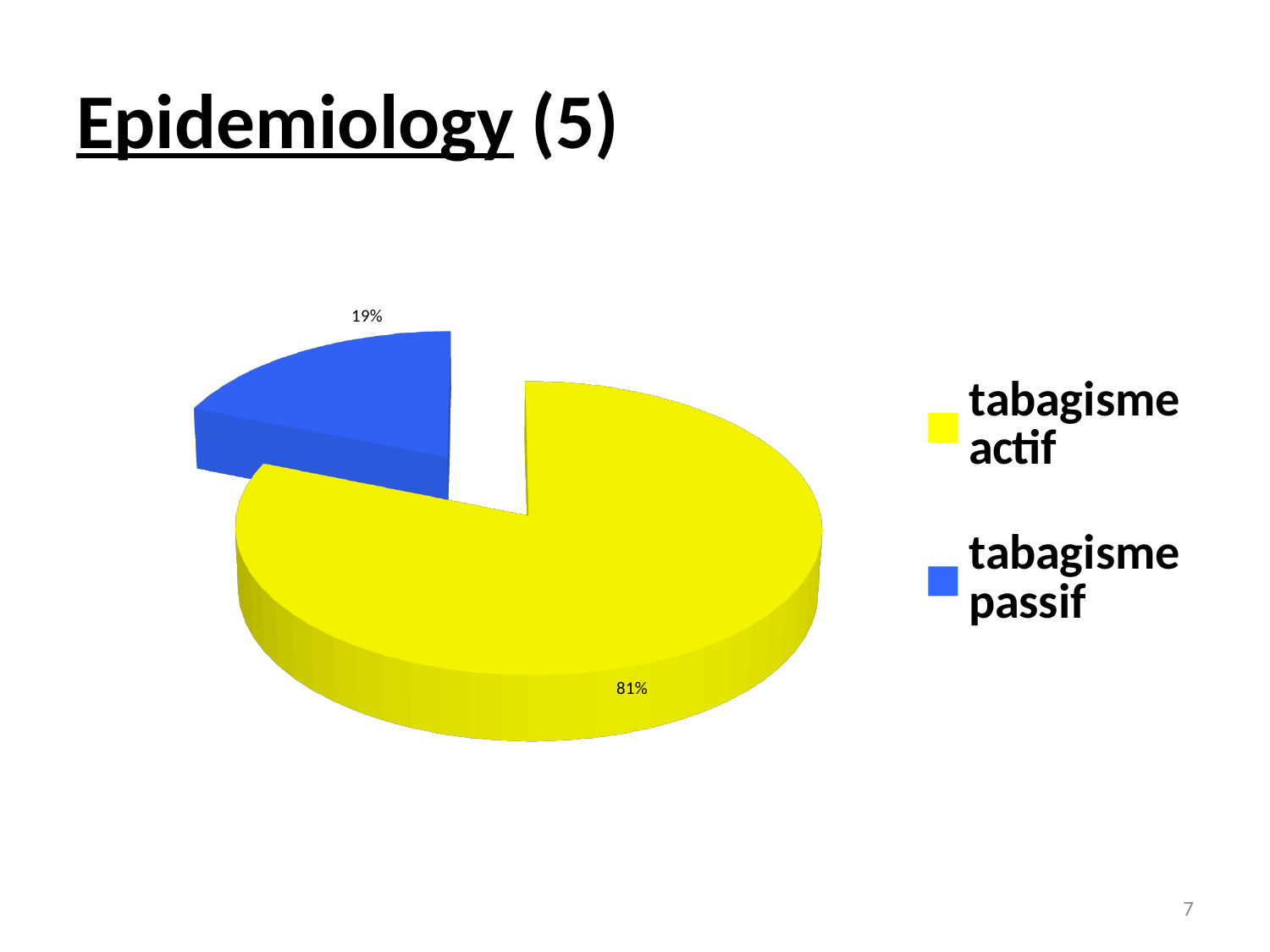
What kind of chart is shown on the slide? pie chart How many entries does the legend list? 2 What share of the pie does tabagisme actif represent? 81% What share of the pie does tabagisme passif represent? 19% Which is larger, the slice for tabagisme actif or the slice for tabagisme passif? tabagisme actif How many slices does the pie chart have? 2 What colour is the slice for tabagisme passif? blue What is the difference in percentage points between tabagisme actif and tabagisme passif? 62 What colour is the slice for tabagisme actif? yellow Which category has the largest slice of the pie? tabagisme actif Which category has the smallest slice of the pie? tabagisme passif